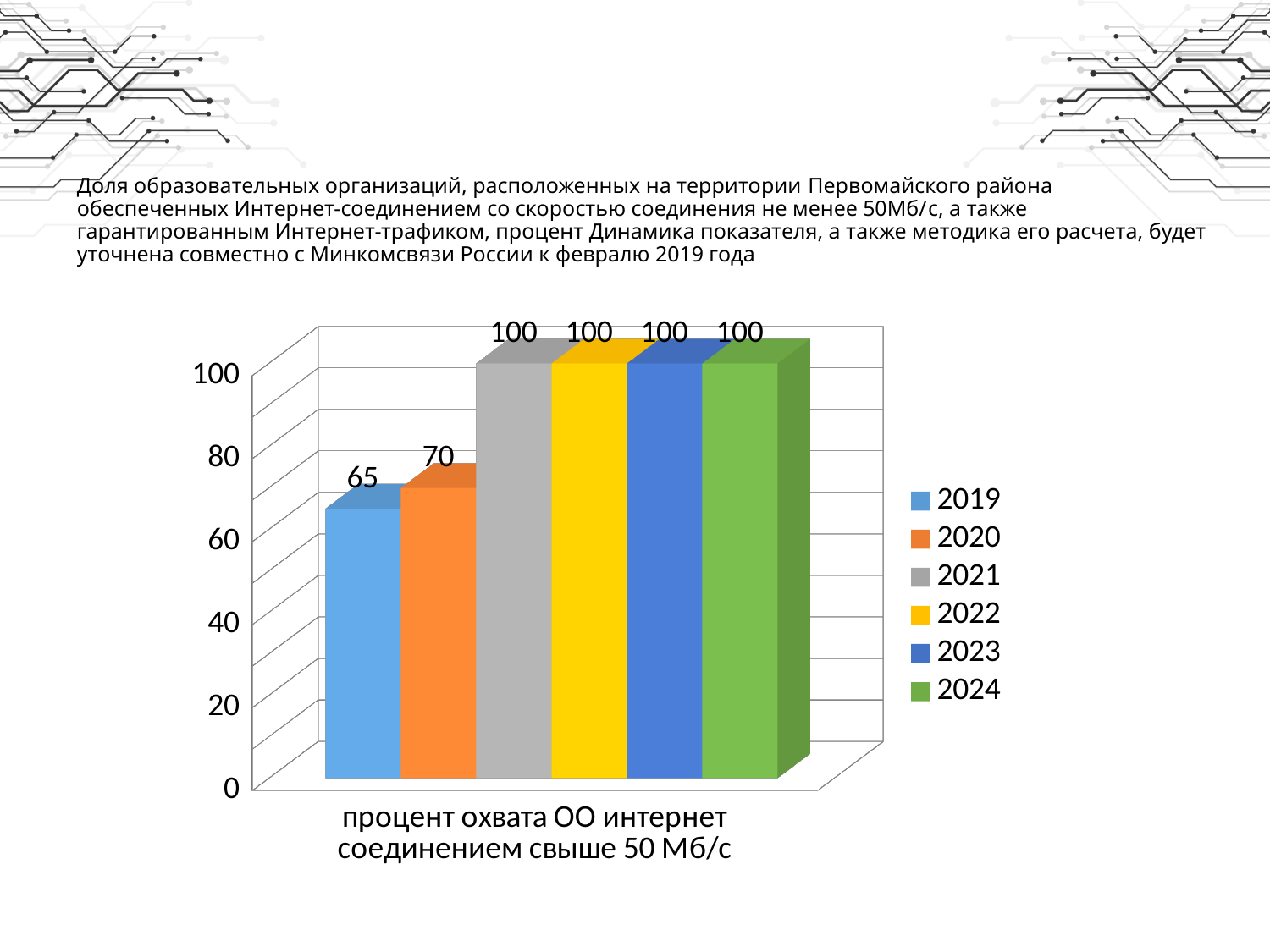
Which is larger, the value for 2019 or the value for 2020? 2020 Do the values rise or fall from the 2019 series to the 2024 series? rise Is the value for 2019 greater or less than 80? less What kind of chart is shown on the slide? bar chart What is the difference between the values for 2020 and 2019? 5 What is the value for the 2022 series? 100 What is the value for the 2019 series? 65 How many series does the legend list? 6 Which series has the lowest value? 2019 What is the difference between the values for 2021 and 2020? 30 What is the category label shown on the x axis of the chart? процент охвата ОО интернет соединением свыше 50 Мб/с What is the value for the 2020 series? 70